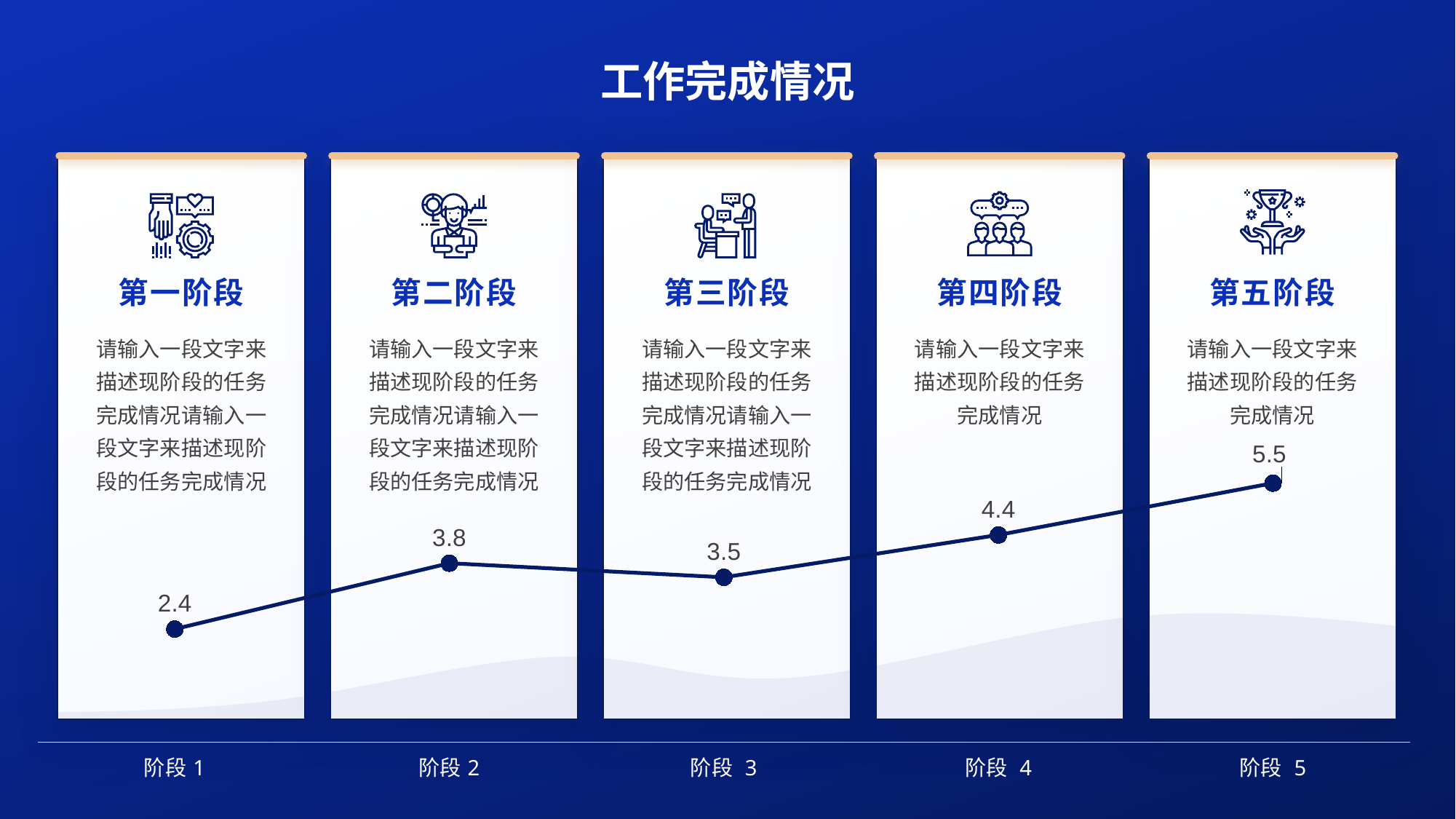
What is the difference between the values for 阶段 5 and 阶段 1? 3.1 What is the value for 阶段 1? 2.4 Do the values generally rise or fall from 阶段 1 to 阶段 5? rise Which stage has the highest value? 阶段 5 Which stage has the lowest value? 阶段 1 What is the title of the slide containing the chart? 工作完成情况 What kind of chart is shown on the slide? line chart What is the value for 阶段 3? 3.5 Which is larger, the value for 阶段 2 or 阶段 3? 阶段 2 What is the value for 阶段 5? 5.5 How many data points are plotted on the line? 5 What is the difference between the values for 阶段 2 and 阶段 3? 0.3